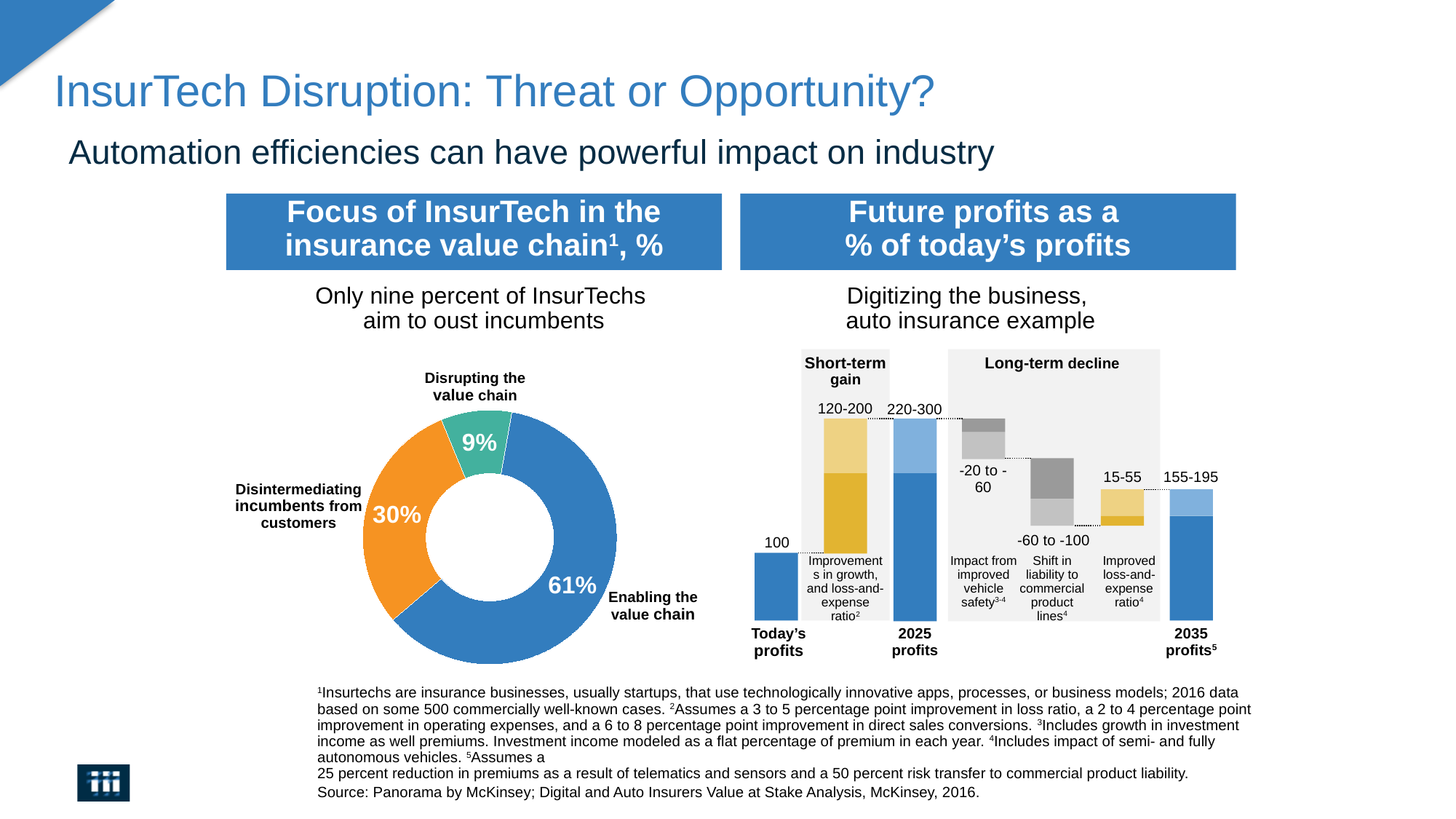
What kind of chart is the 'Focus of InsurTech in the insurance value chain' chart? Donut (pie) chart In the 'Future profits as a % of today's profits' chart, what value is shown for 2035 profits? 155-195 In the 'Future profits as a % of today's profits' chart, what value is shown for today's profits? 100 In the 'Focus of InsurTech in the insurance value chain' chart, what share is labelled 'Disintermediating incumbents from customers'? 30% In the 'Future profits as a % of today's profits' chart, what value is shown for 2025 profits? 220-300 In the 'Focus of InsurTech in the insurance value chain' chart, what percentage of InsurTechs are enabling the value chain? 61% In the 'Focus of InsurTech in the insurance value chain' chart, how many categories are shown? 3 In the 'Future profits as a % of today's profits' chart, what is the range shown for 'Shift in liability to commercial product lines'? -60 to -100 In the 'Focus of InsurTech in the insurance value chain' chart, what share is labelled 'Disrupting the value chain'? 9% In the 'Focus of InsurTech in the insurance value chain' chart, which category has the largest share? Enabling the value chain In the 'Focus of InsurTech in the insurance value chain' chart, how many percentage points larger is 'Enabling the value chain' than 'Disintermediating incumbents from customers'? 31 percentage points In the 'Focus of InsurTech in the insurance value chain' chart, which category has the smallest share? Disrupting the value chain